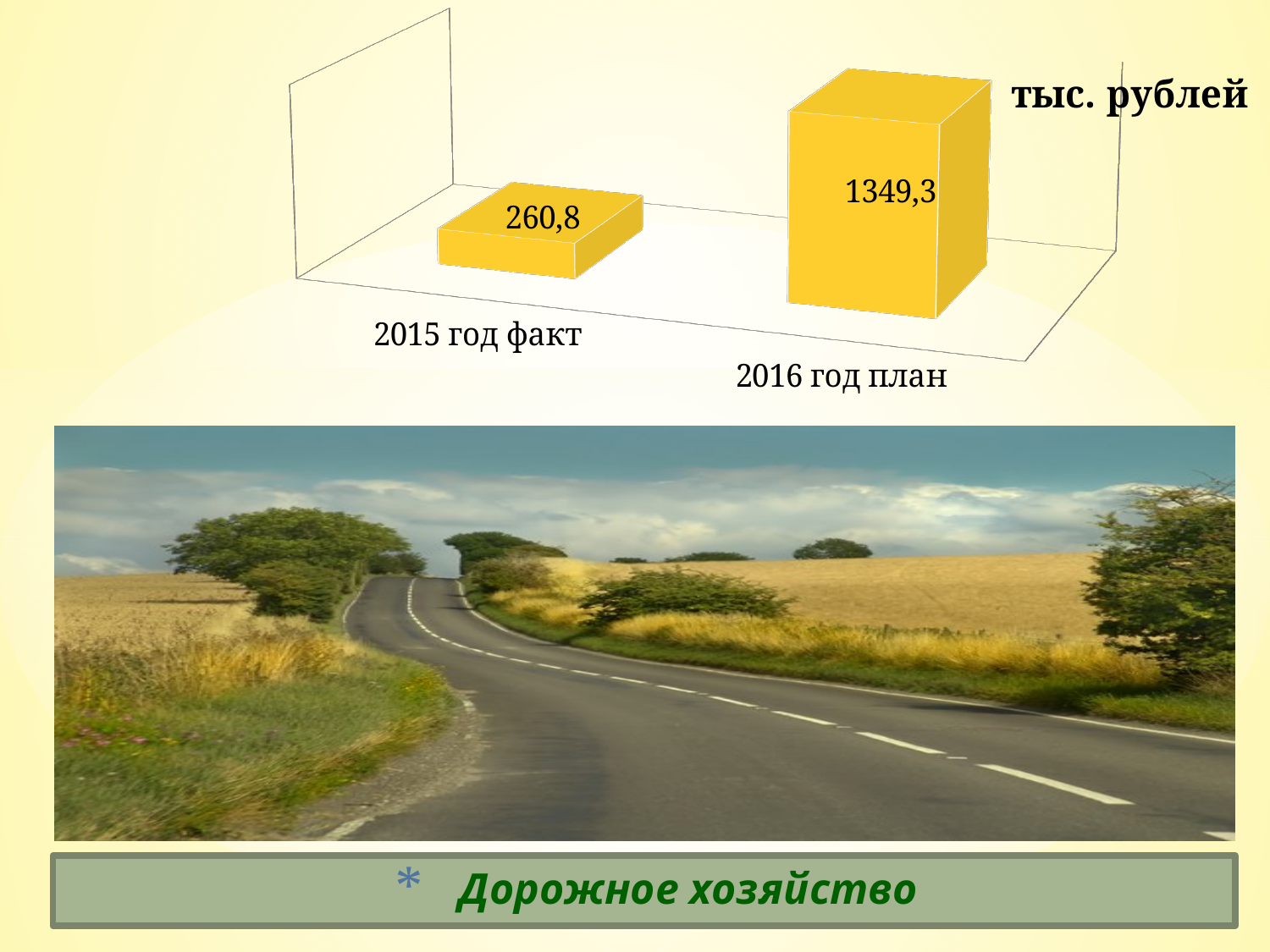
How many categories are shown in the chart? 2 What is the difference between the values for 2016 год план and 2015 год факт? 1088,5 Which is larger, the value for 2015 год факт or the value for 2016 год план? 2016 год план What kind of chart is shown on the slide? bar chart Which category has the lowest value? 2015 год факт Which category has the highest value? 2016 год план What is the value for 2016 год план? 1349,3 What unit is indicated for the values in the chart? тыс. рублей What colour are the bars in the chart? yellow What is the value for 2015 год факт? 260,8 Do the values rise or fall from 2015 год факт to 2016 год план? rise